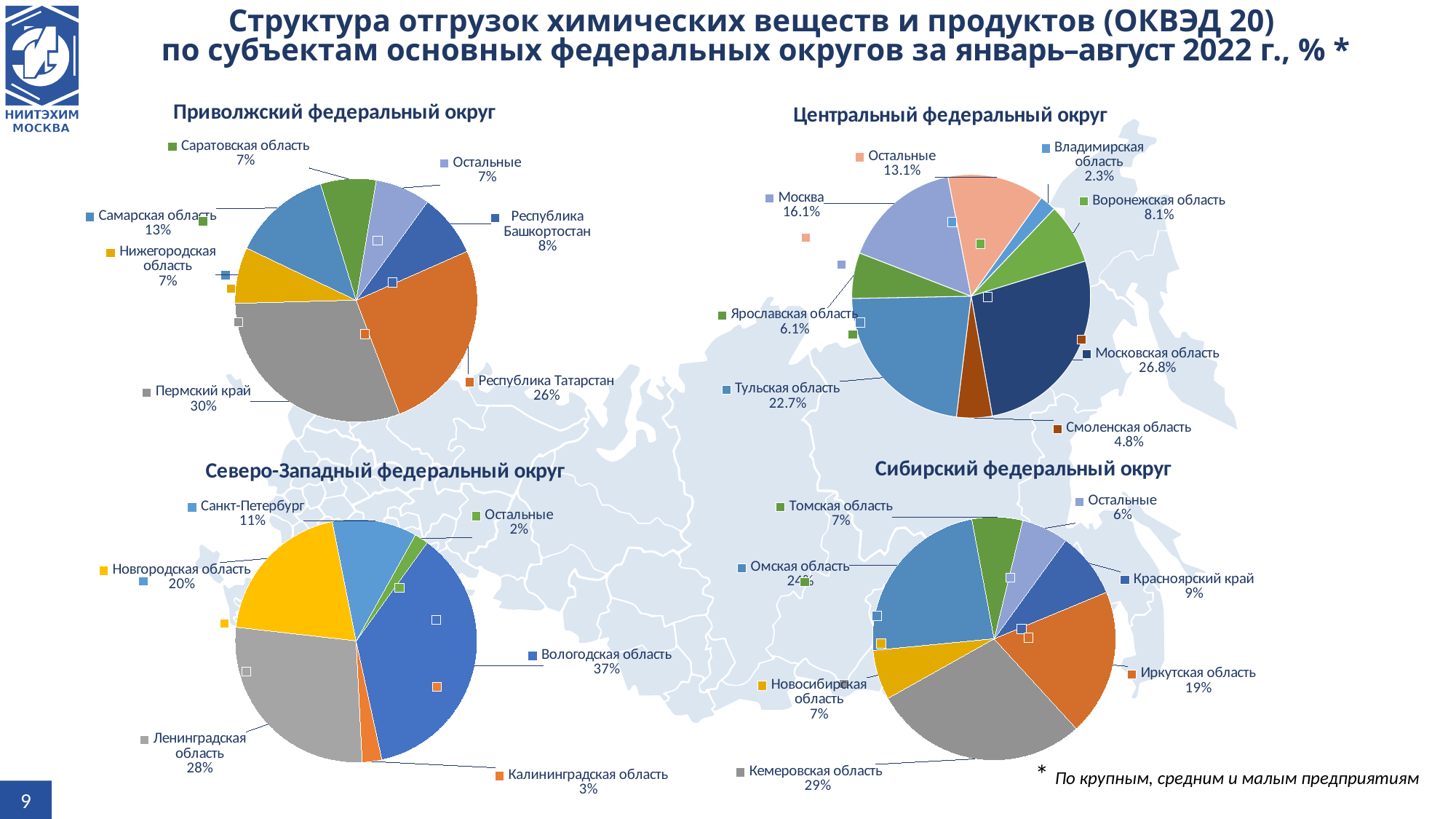
In the Центральный федеральный округ pie chart, what is the share of Московская область? 26.8% In the Северо-Западный федеральный округ pie chart, what share does Вологодская область have? 37% What type of chart is used for the Сибирский федеральный округ? Pie chart In the Приволжский федеральный округ pie chart, which is larger: the share of Республика Татарстан or the share of Самарская область? Республика Татарстан In the Сибирский федеральный округ pie chart, what is the share of Иркутская область? 19% How many pie charts are shown on the slide? 4 In the Сибирский федеральный округ pie chart, which region has the largest share? Кемеровская область In the Центральный федеральный округ pie chart, what is the difference between the shares of Московская область and Тульская область? 4.1% How many slices does the Центральный федеральный округ pie chart have? 8 In the Приволжский федеральный округ pie chart, what share does Пермский край have? 30% In the Северо-Западный федеральный округ pie chart, which slice is the smallest? Остальные In the Центральный федеральный округ pie chart, which region has the smallest share? Владимирская область